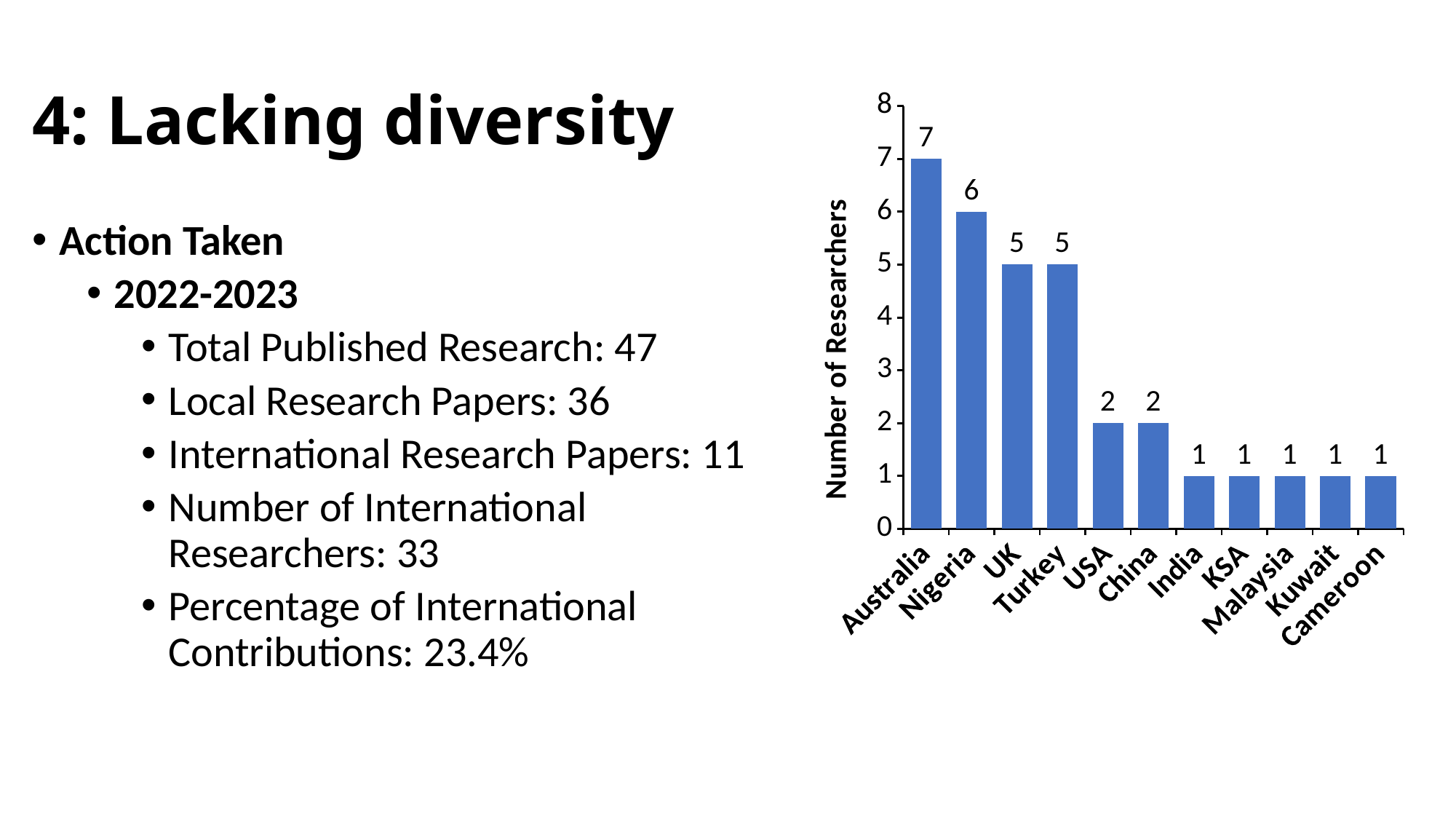
What is the number of researchers for Turkey? 5 What is the difference in number of researchers between Australia and Nigeria? 1 What is the number of researchers for Australia? 7 What is the difference in number of researchers between the UK and the USA? 3 Is the value for Australia greater or less than 6? greater Which country has the highest number of researchers? Australia What is the number of researchers for Nigeria? 6 How many countries are shown on the x axis of the chart? 11 Which has more researchers, Nigeria or Turkey? Nigeria What is the number of researchers for China? 2 What kind of chart is shown on the slide? bar chart What is the label of the vertical axis of the chart? Number of Researchers